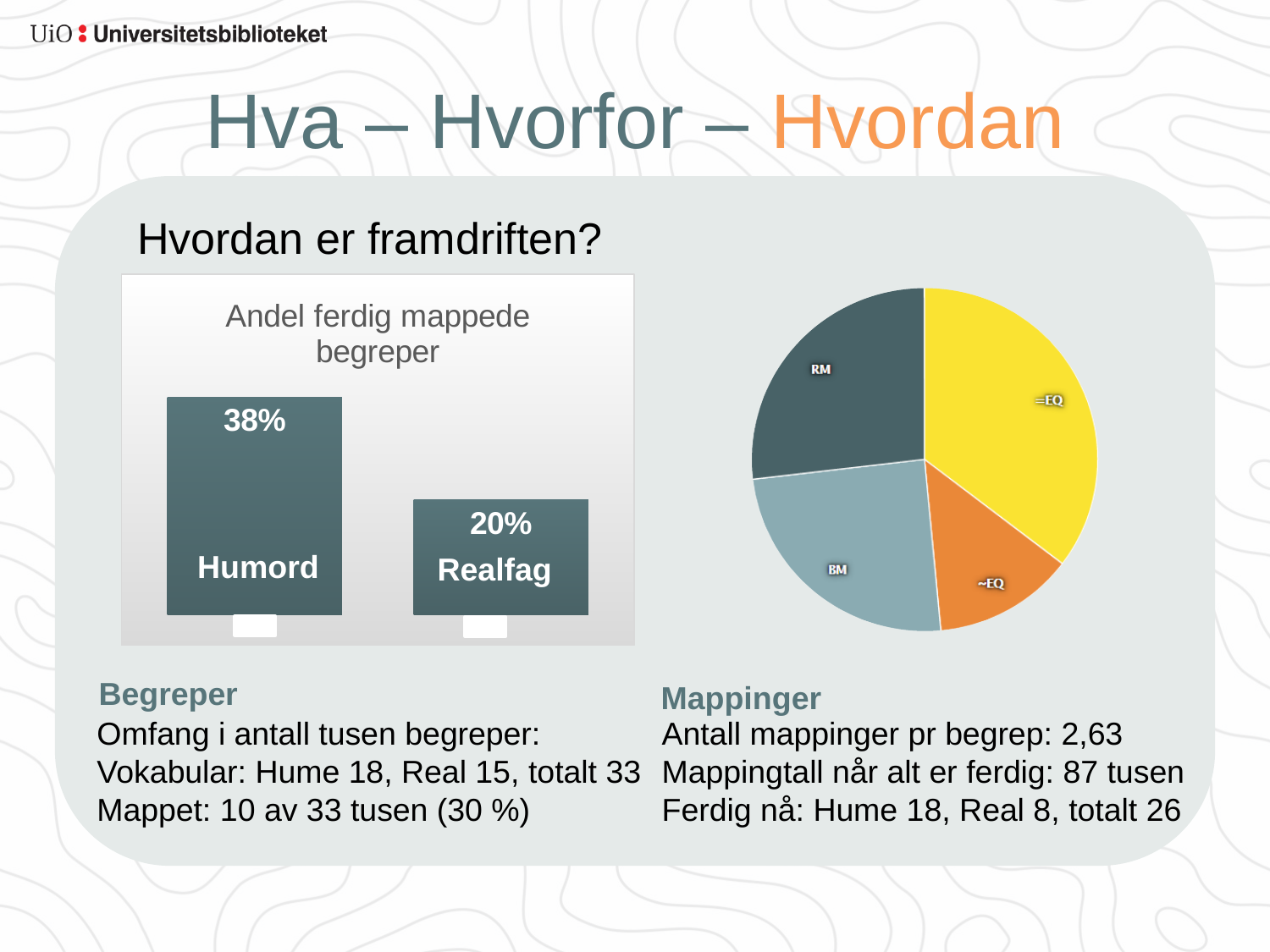
What kind of chart is the chart on the right of the slide? Pie chart How many slices does the pie chart on the right of the slide have? 4 In the bar chart 'Andel ferdig mappede begreper', what is the value for Humord? 38% In the bar chart 'Andel ferdig mappede begreper', which category has the highest value? Humord In the bar chart 'Andel ferdig mappede begreper', what is the value for Realfag? 20% What kind of chart is the chart on the left of the slide? Bar chart In the bar chart 'Andel ferdig mappede begreper', which category has the lowest value? Realfag In the bar chart 'Andel ferdig mappede begreper', what is the difference between the values for Humord and Realfag? 18% In the bar chart 'Andel ferdig mappede begreper', which is larger, the value for Humord or the value for Realfag? Humord In the pie chart on the right of the slide, which slice is the largest? =EQ How many categories are shown in the bar chart 'Andel ferdig mappede begreper'? 2 What is the title of the chart on the left of the slide? Andel ferdig mappede begreper